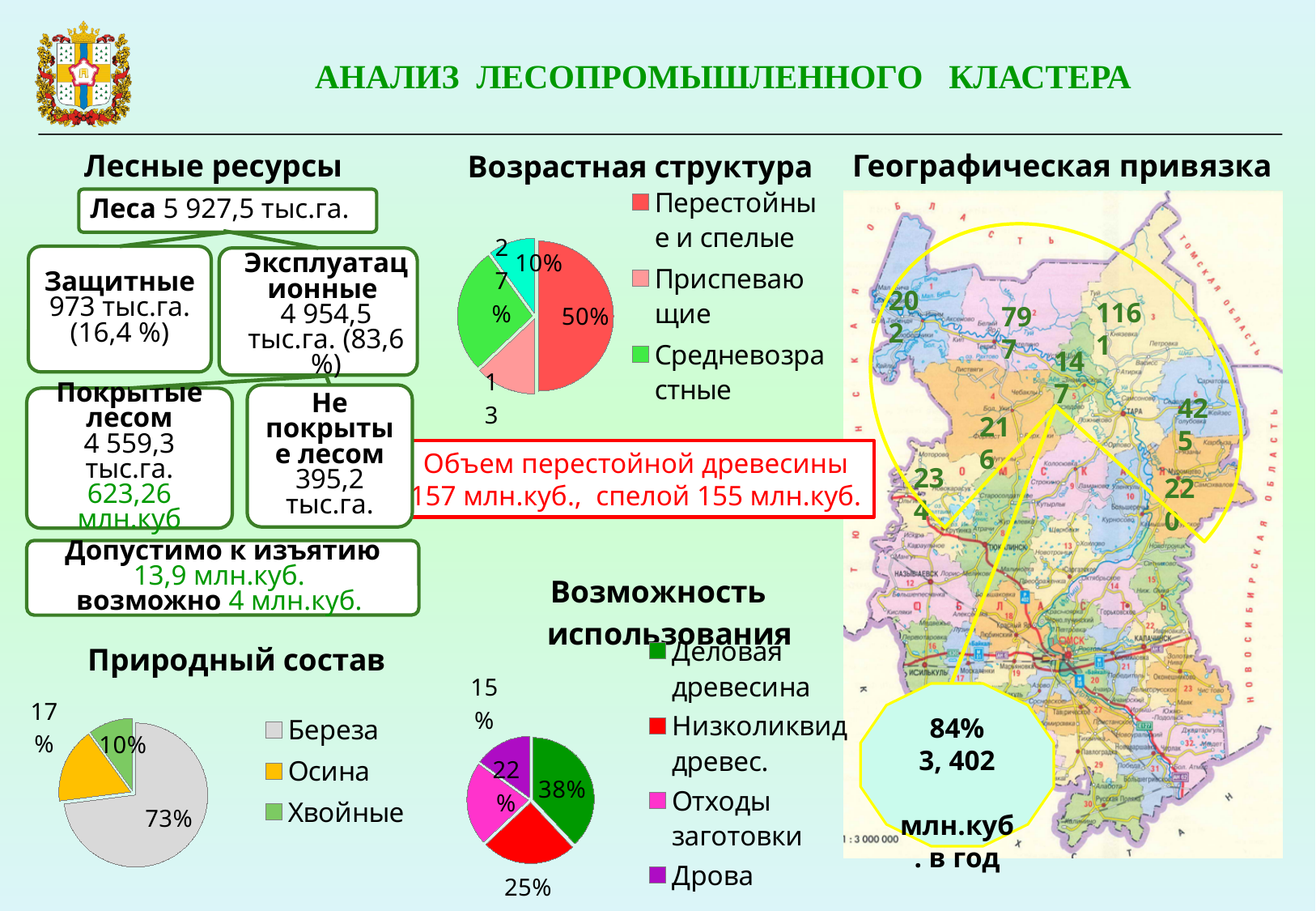
In the 'Природный состав' pie chart, how many categories does the legend list? 3 In the 'Возможность использования' pie chart, how many slices are there? 4 In the 'Возможность использования' pie chart, what share does Деловая древесина have? 38% In the 'Возможность использования' pie chart, what is the difference between the shares of Низколиквид древес. and Отходы заготовки? 3% In the 'Возможность использования' pie chart, which category has the largest share? Деловая древесина In the 'Возрастная структура' pie chart, which is larger: Средневозрастные or Приспевающие? Средневозрастные In the 'Возможность использования' pie chart, what share does Дрова have? 15% In the 'Природный состав' pie chart, what share does Осина have? 17% In the 'Природный состав' pie chart, which category has the smallest share? Хвойные In the 'Возрастная структура' pie chart, what share do Перестойные и спелые have? 50% In the 'Природный состав' pie chart, what share does Береза have? 73% What type of chart is used for 'Природный состав'? Pie chart